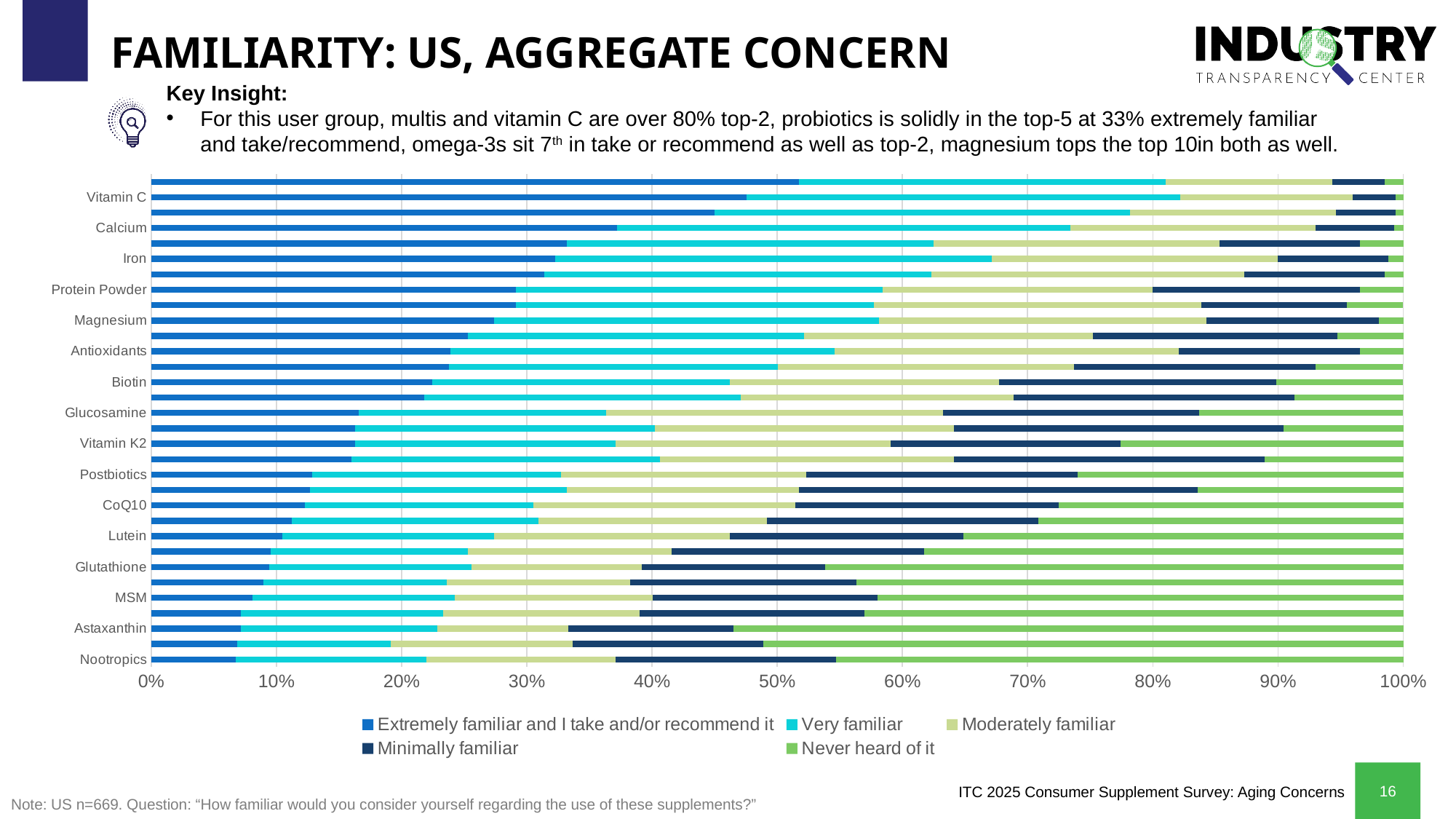
Is the 'Never heard of it' value for Vitamin C greater or less than 10%? less Moving down the chart from Vitamin C to Nootropics, does the 'Extremely familiar and I take and/or recommend it' share rise or fall? fall Which has a larger 'Extremely familiar and I take and/or recommend it' share, Calcium or Lutein? Calcium Is the 'Extremely familiar and I take and/or recommend it' value for Nootropics greater or less than 10%? less What is the title of the slide containing the chart? FAMILIARITY: US, AGGREGATE CONCERN What kind of chart is shown on the slide? Stacked horizontal bar chart Is the 'Extremely familiar and I take and/or recommend it' value for Vitamin C greater or less than 40%? greater Which has a larger 'Extremely familiar and I take and/or recommend it' share, Vitamin C or Nootropics? Vitamin C Among the labeled categories, which has the largest 'Extremely familiar and I take and/or recommend it' share? Vitamin C How many series does the legend list? 5